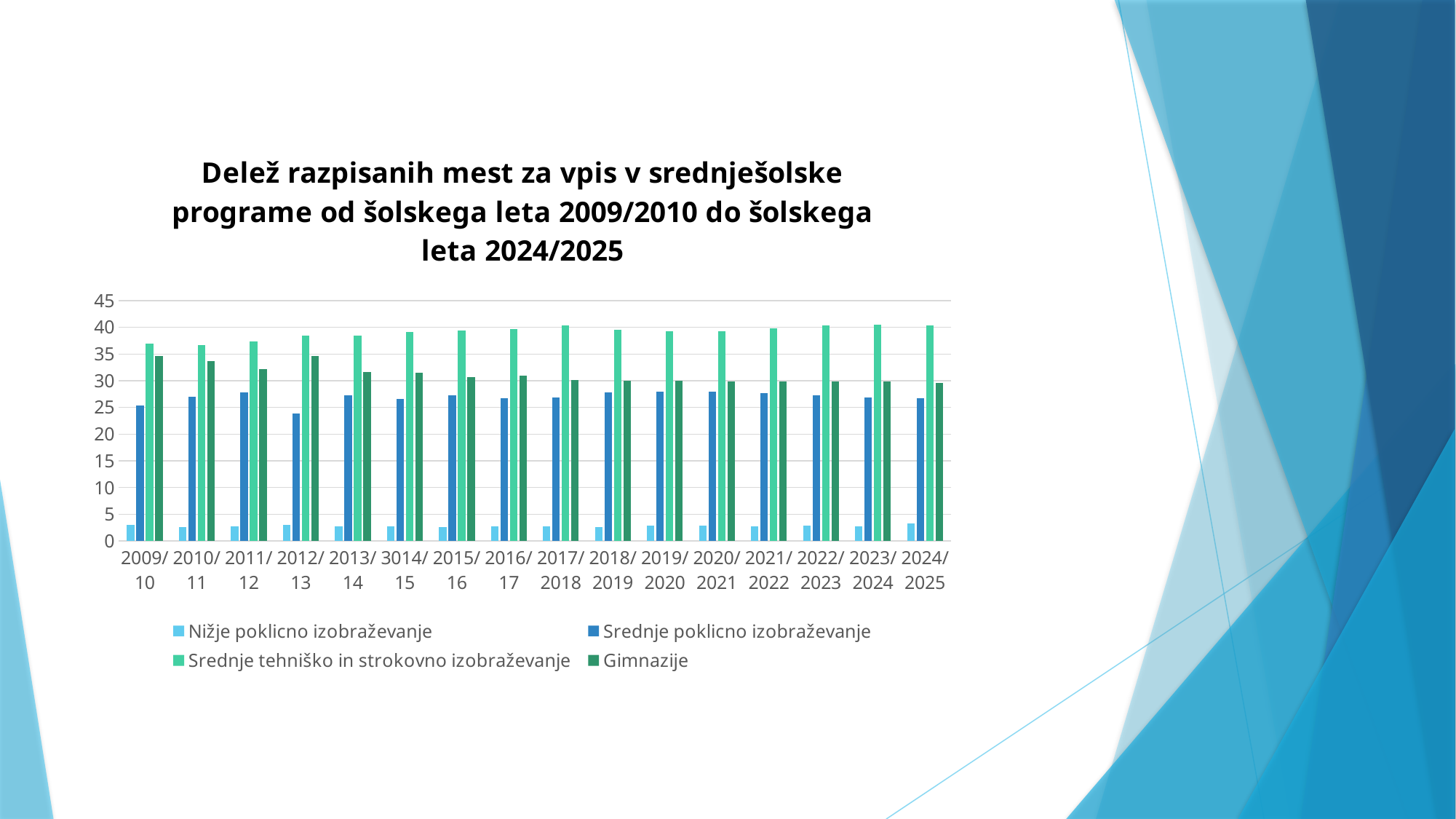
How many series does the legend list? 4 Is the value for Srednje poklicno izobraževanje in 2009/10 greater or less than 20? greater Which series has the highest value in 2017/2018? Srednje tehniško in strokovno izobraževanje Is the value for Srednje tehniško in strokovno izobraževanje in 2009/10 greater or less than 35? greater In 2009/10, which is larger: Gimnazije or Srednje poklicno izobraževanje? Gimnazije Is the value for Gimnazije in 2009/10 greater or less than 30? greater In 2024/2025, which is larger: Srednje tehniško in strokovno izobraževanje or Gimnazije? Srednje tehniško in strokovno izobraževanje Do the values for Gimnazije rise or fall from 2009/10 to 2024/2025? fall What kind of chart is shown on the slide? bar chart How many school years are shown on the x axis? 16